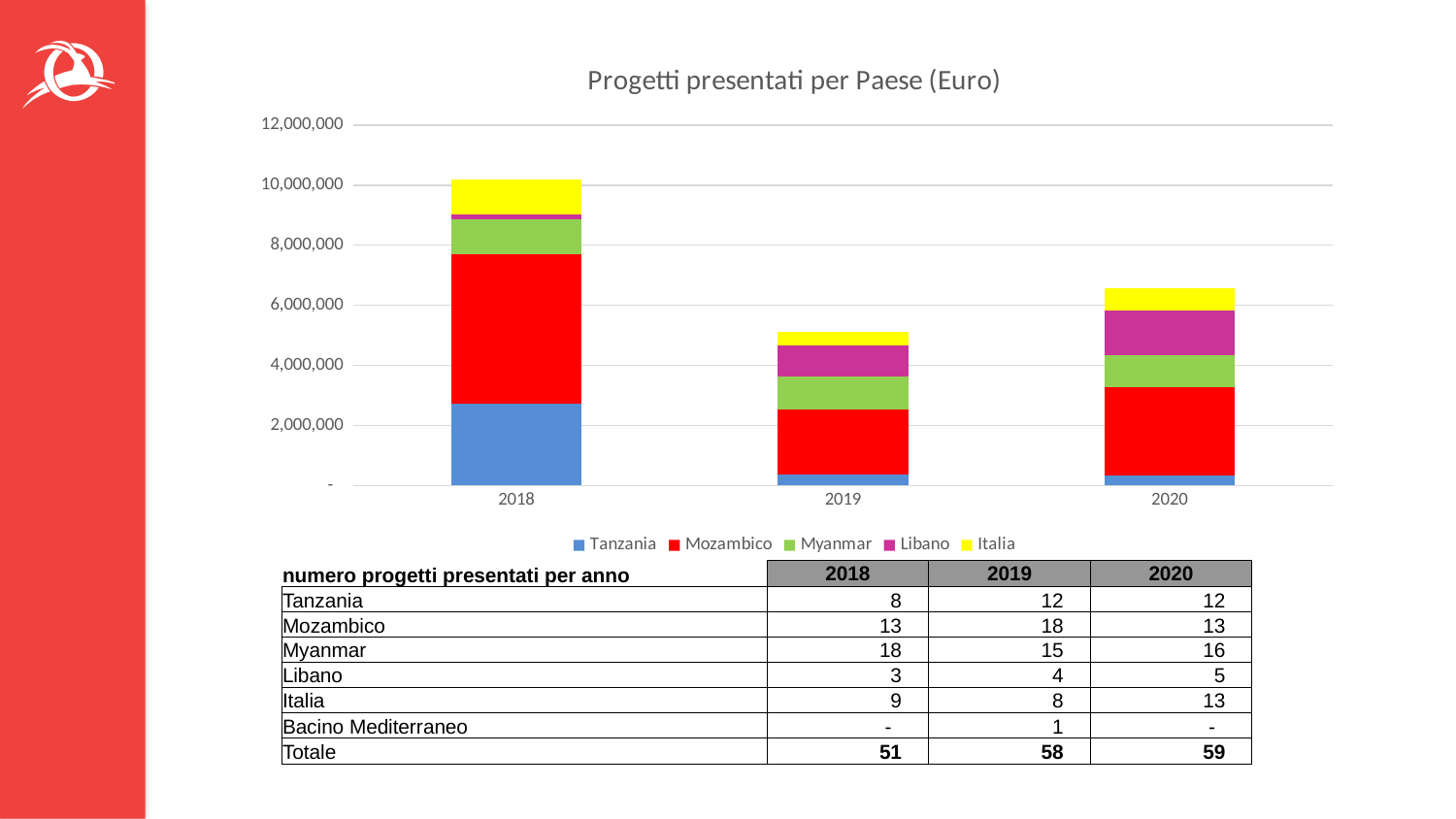
Is the Mozambico segment in 2018 larger or smaller than the Mozambico segment in 2020? larger What is the title of the chart? Progetti presentati per Paese (Euro) How many series does the chart legend list? 5 Which year has the lowest total stacked bar in the chart? 2019 How many years are shown on the x axis of the chart? 3 What kind of chart is shown on the slide? stacked bar chart Is the Libano segment in 2020 larger or smaller than the Libano segment in 2018? larger Is the total value of the 2019 bar greater or less than 6,000,000? less Is the total value of the 2020 bar greater or less than 6,000,000? greater Which year has the highest total stacked bar in the chart? 2018 Is the total value of the 2018 bar greater or less than 8,000,000? greater Which colour represents Italia in the chart legend? yellow